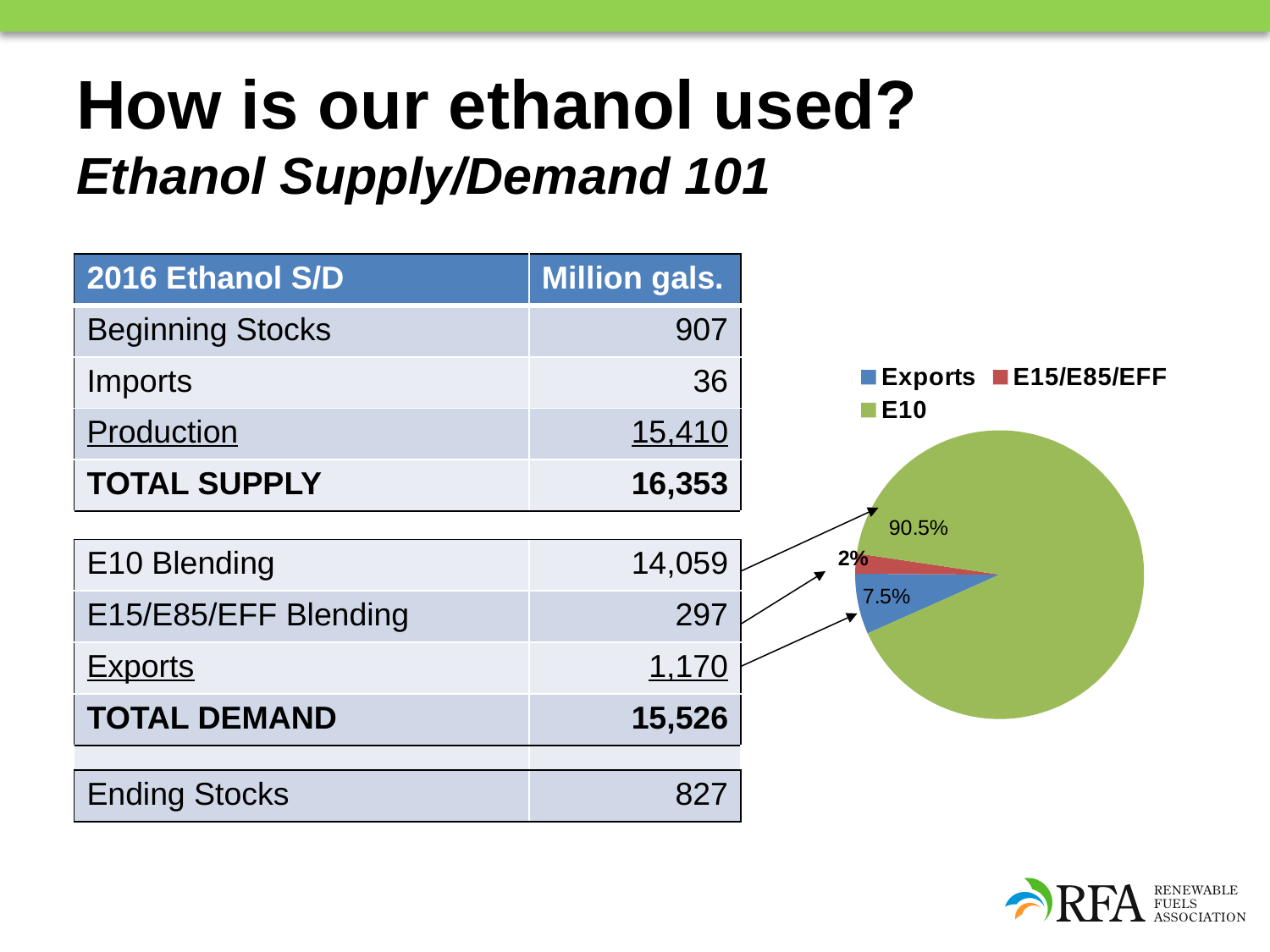
How many entries does the pie chart's legend list? 3 What kind of chart is shown on the slide? pie chart Which slice of the pie chart is the smallest? E15/E85/EFF Which slice of the pie chart is the largest? E10 What is the difference in percentage points between the E10 slice and the Exports slice in the pie chart? 83 percentage points In the pie chart, which is larger, the Exports slice or the E15/E85/EFF slice? Exports What share of the pie chart is Exports? 7.5% How many slices does the pie chart have? 3 What share of the pie chart is E15/E85/EFF? 2% What share of the pie chart is E10? 90.5% What colour is the E10 slice in the pie chart? green Which legend entry in the pie chart is shown in red? E15/E85/EFF